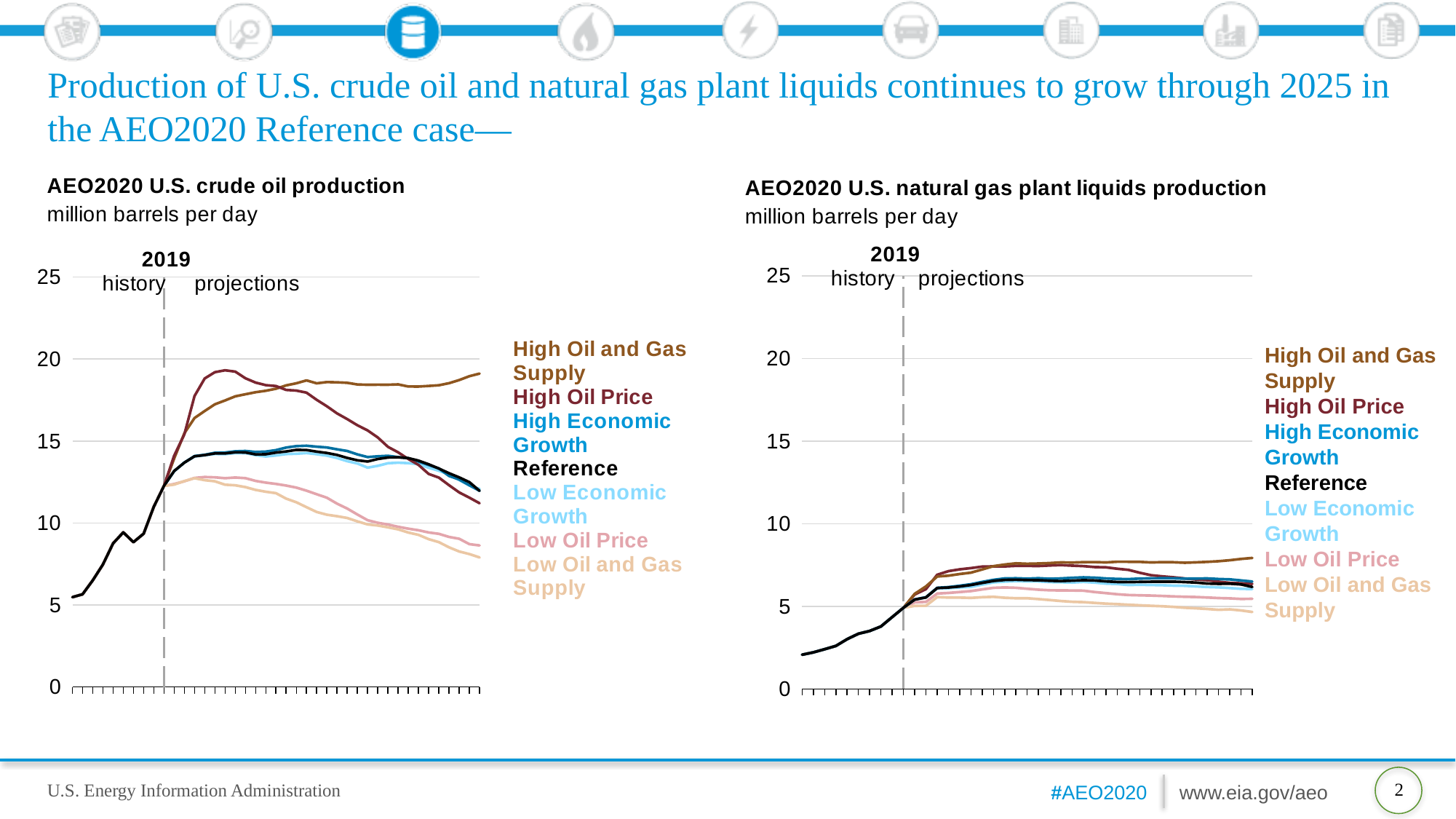
In the AEO2020 U.S. crude oil production chart, what unit is shown under the title? million barrels per day In the AEO2020 U.S. natural gas plant liquids production chart, is the Low Oil and Gas Supply value at the end of the projection period greater or less than 5? less In the AEO2020 U.S. crude oil production chart, which series ends the projection period at the highest value? High Oil and Gas Supply In the AEO2020 U.S. crude oil production chart, which series ends the projection period at the lowest value? Low Oil and Gas Supply In the AEO2020 U.S. natural gas plant liquids production chart, does production rise or fall over the history period before 2019? rise In the AEO2020 U.S. crude oil production chart, is the Reference case value at its peak greater or less than 15? less How many series does the legend of the AEO2020 U.S. natural gas plant liquids production chart list? 7 In the AEO2020 U.S. natural gas plant liquids production chart, is the High Oil and Gas Supply value at the end of the projection period greater or less than 10? less In the AEO2020 U.S. crude oil production chart, which year does the dashed vertical line separating history and projections mark? 2019 What kind of chart is the AEO2020 U.S. crude oil production chart? line chart